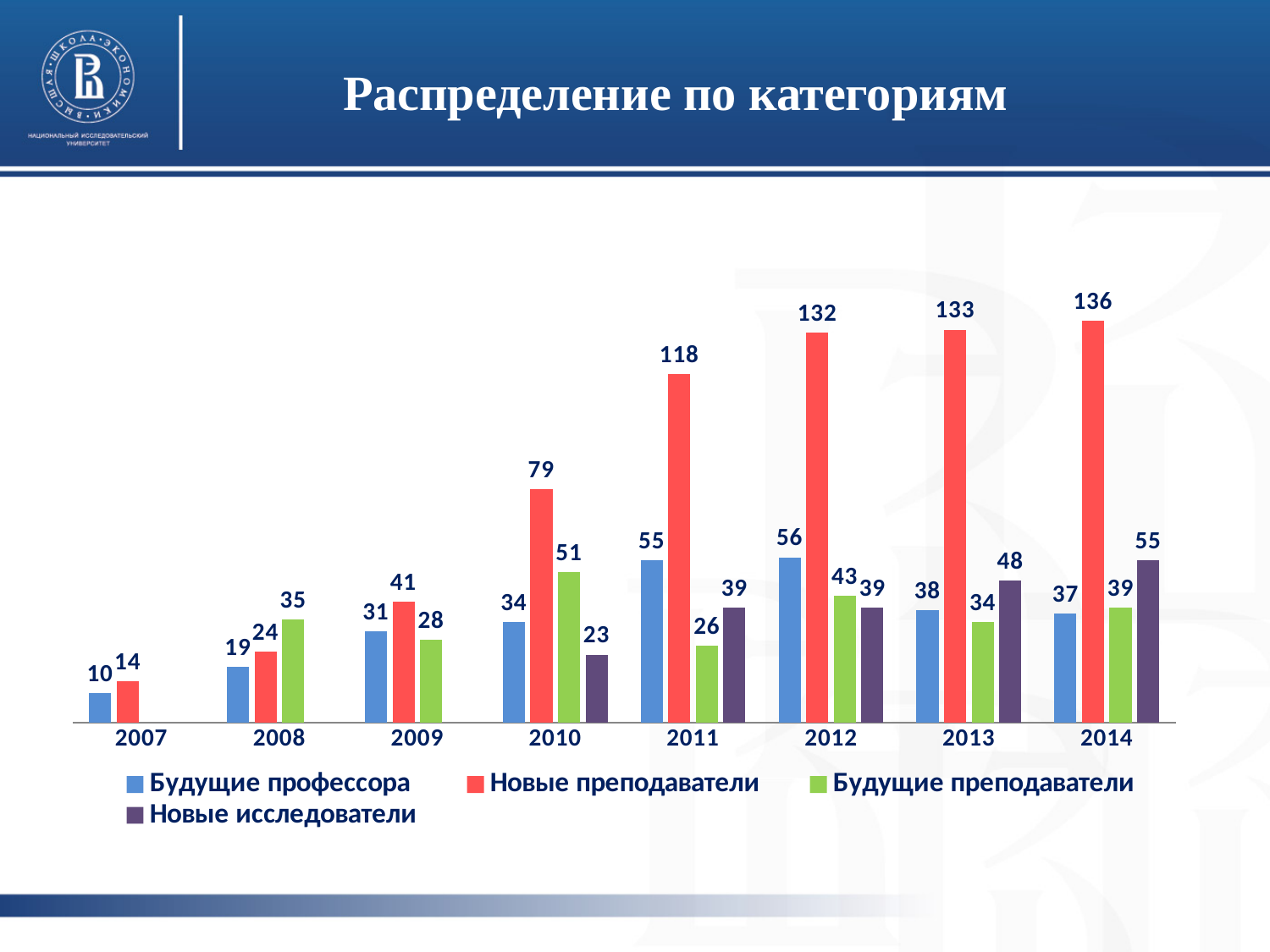
In which year is the value for Будущие профессора the lowest? 2007 What kind of chart is shown on the slide? Bar chart Which is larger in 2008: Будущие преподаватели or Новые преподаватели? Будущие преподаватели What is the difference between Новые преподаватели and Будущие профессора in 2012? 76 What is the value for Новые исследователи in 2010? 23 How many years are shown on the x axis? 8 In which year is the value for Новые преподаватели the highest? 2014 What is the value for Новые преподаватели in 2014? 136 What is the value for Будущие преподаватели in 2009? 28 What is the title of the slide? Распределение по категориям How many series does the legend list? 4 What is the value for Будущие профессора in 2011? 55